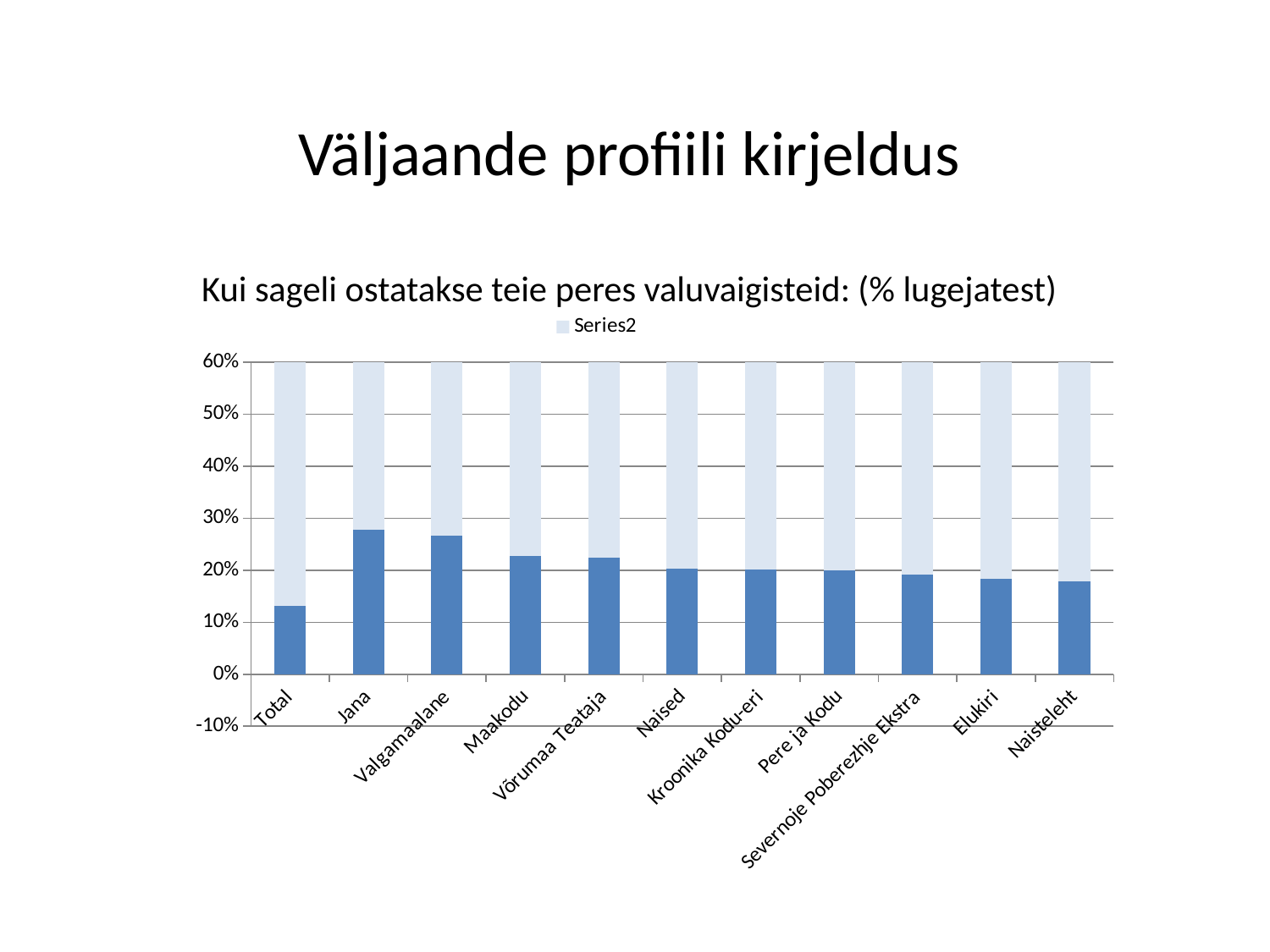
Is the dark blue value for Naisteleht greater or less than 20%? less Which has the larger dark blue bar, Maakodu or Naisteleht? Maakodu What is the title of the chart? Kui sageli ostatakse teie peres valuvaigisteid: (% lugejatest) Which has the larger dark blue bar, Jana or Total? Jana Is the dark blue value for Jana greater or less than 20%? greater What kind of chart is shown on the slide? bar chart Is the dark blue value for Total greater or less than 10%? greater How many series does the chart's legend list? 1 How many categories are shown on the x axis of the chart? 11 Which category has the lowest dark blue bar? Total